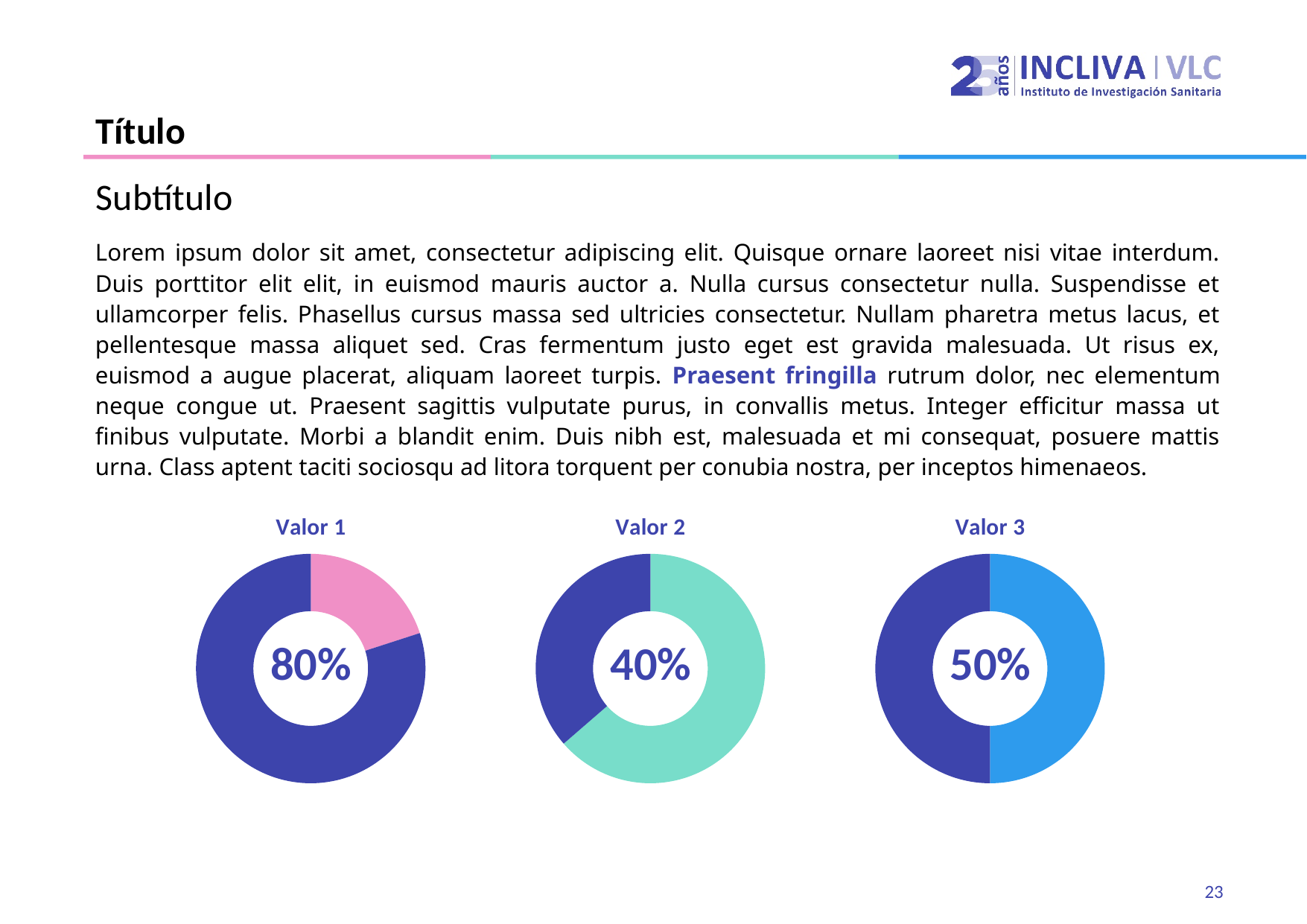
Which is larger, the percentage shown for Valor 1 or the percentage shown for Valor 3? Valor 1 How many donut charts are shown on the slide? 3 Which of the three donut charts shows the highest percentage? Valor 1 Which of the three donut charts shows the lowest percentage? Valor 2 What is the difference between the percentage shown for Valor 3 and the percentage shown for Valor 2? 10% What is the difference between the percentage shown for Valor 1 and the percentage shown for Valor 2? 40% What kind of chart is used for Valor 1, Valor 2 and Valor 3? Donut chart What value is shown in the centre of the "Valor 2" donut chart? 40% What value is shown in the centre of the "Valor 1" donut chart? 80% In the "Valor 3" donut chart, what colour is the segment on the right half? Light blue In the "Valor 1" donut chart, what colour is the smaller segment? Pink What value is shown in the centre of the "Valor 3" donut chart? 50%